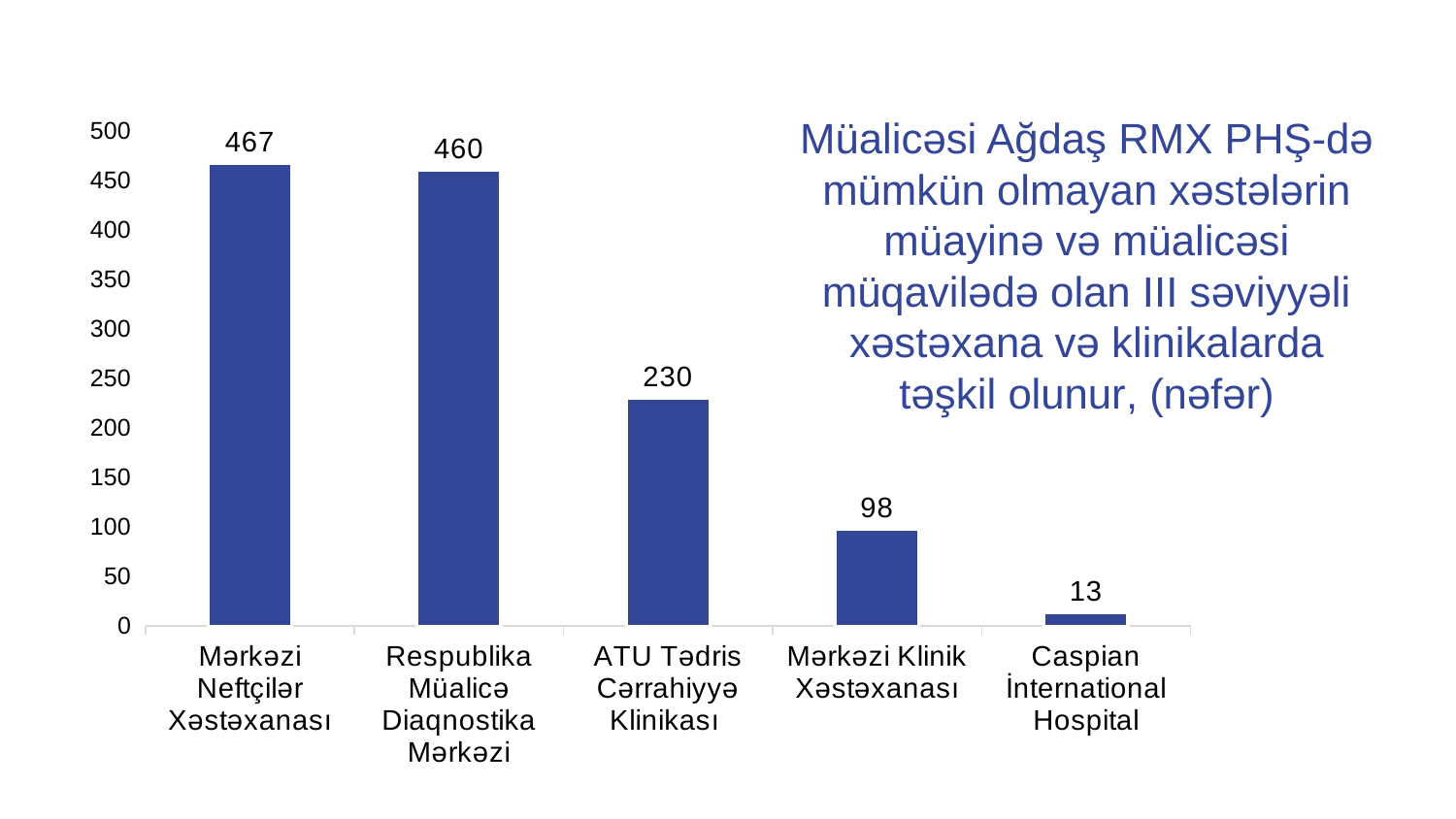
What is the value for ATU Tədris Cərrahiyyə Klinikası? 230 What is the value for Mərkəzi Neftçilər Xəstəxanası? 467 Is the value for ATU Tədris Cərrahiyyə Klinikası greater or less than 200? greater What is the difference between the values for ATU Tədris Cərrahiyyə Klinikası and Mərkəzi Klinik Xəstəxanası? 132 Which category has the highest value? Mərkəzi Neftçilər Xəstəxanası Which category has the lowest value? Caspian İnternational Hospital Which is larger: the value for Mərkəzi Klinik Xəstəxanası or the value for Caspian İnternational Hospital? Mərkəzi Klinik Xəstəxanası What is the value for Caspian İnternational Hospital? 13 What is the value for Respublika Müalicə Diaqnostika Mərkəzi? 460 How many categories are shown on the x axis? 5 What kind of chart is shown on the slide? bar chart Do the values rise or fall from left to right along the x axis? fall